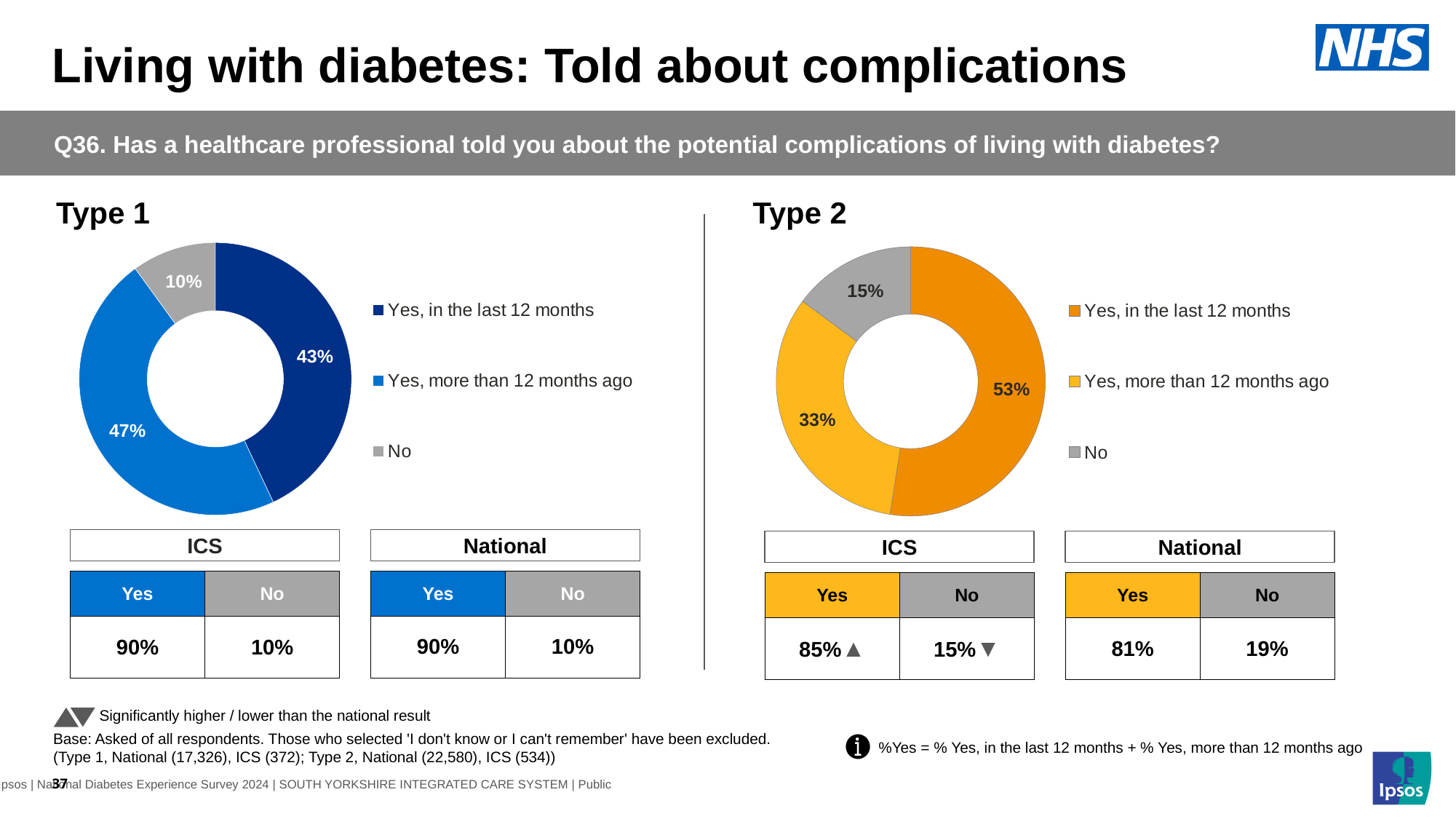
In the Type 1 chart, which category has the largest share? Yes, more than 12 months ago In the Type 2 chart, what is the difference between 'Yes, in the last 12 months' and 'Yes, more than 12 months ago'? 20 percentage points In the Type 2 chart, which category has the smallest share? No In the Type 2 chart, what percentage of respondents said 'Yes, in the last 12 months'? 53% In the Type 2 chart, what percentage of respondents said 'No'? 15% In the Type 1 chart, which is larger: 'Yes, in the last 12 months' or 'No'? Yes, in the last 12 months How many categories does the Type 2 chart show? 3 In the Type 1 chart, what percentage of respondents said 'Yes, more than 12 months ago'? 47% In the Type 1 chart, what percentage of respondents said 'Yes, in the last 12 months'? 43% What colour represents 'No' in the Type 2 chart? Grey In the Type 1 chart, what is the combined share of the two 'Yes' categories? 90% What kind of chart is used for Type 1? Doughnut (pie) chart